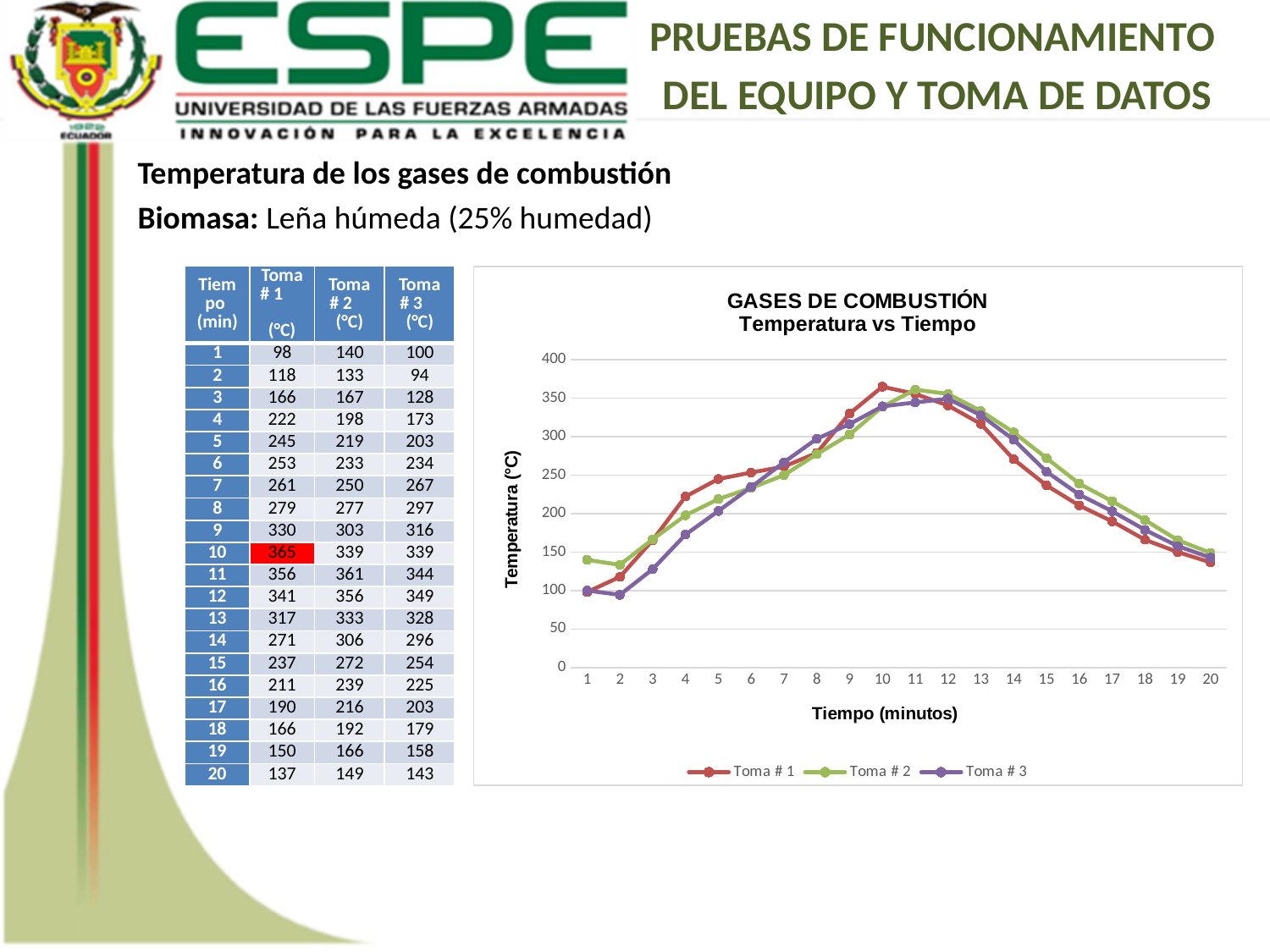
What type of chart is shown on the slide? line chart How many series does the legend of the chart list? 3 At minute 1, which is larger: Toma # 1 or Toma # 2? Toma # 2 Is the value for Toma # 3 at minute 2 greater or less than 100? less Using the table values, what is the difference between Toma # 1 and Toma # 3 at minute 10? 26 How many time points are plotted along the x axis of the chart? 20 According to the table, what is the temperature for Toma # 1 at minute 10? 365 Is the value for Toma # 2 at minute 1 greater or less than 100? greater At which minute does Toma # 1 reach its highest temperature? 10 What is the title of the chart? GASES DE COMBUSTIÓN Temperatura vs Tiempo What is the label of the y axis of the chart? Temperatura (°C) Do the temperatures for Toma # 1 rise or fall from minute 10 to minute 20? fall